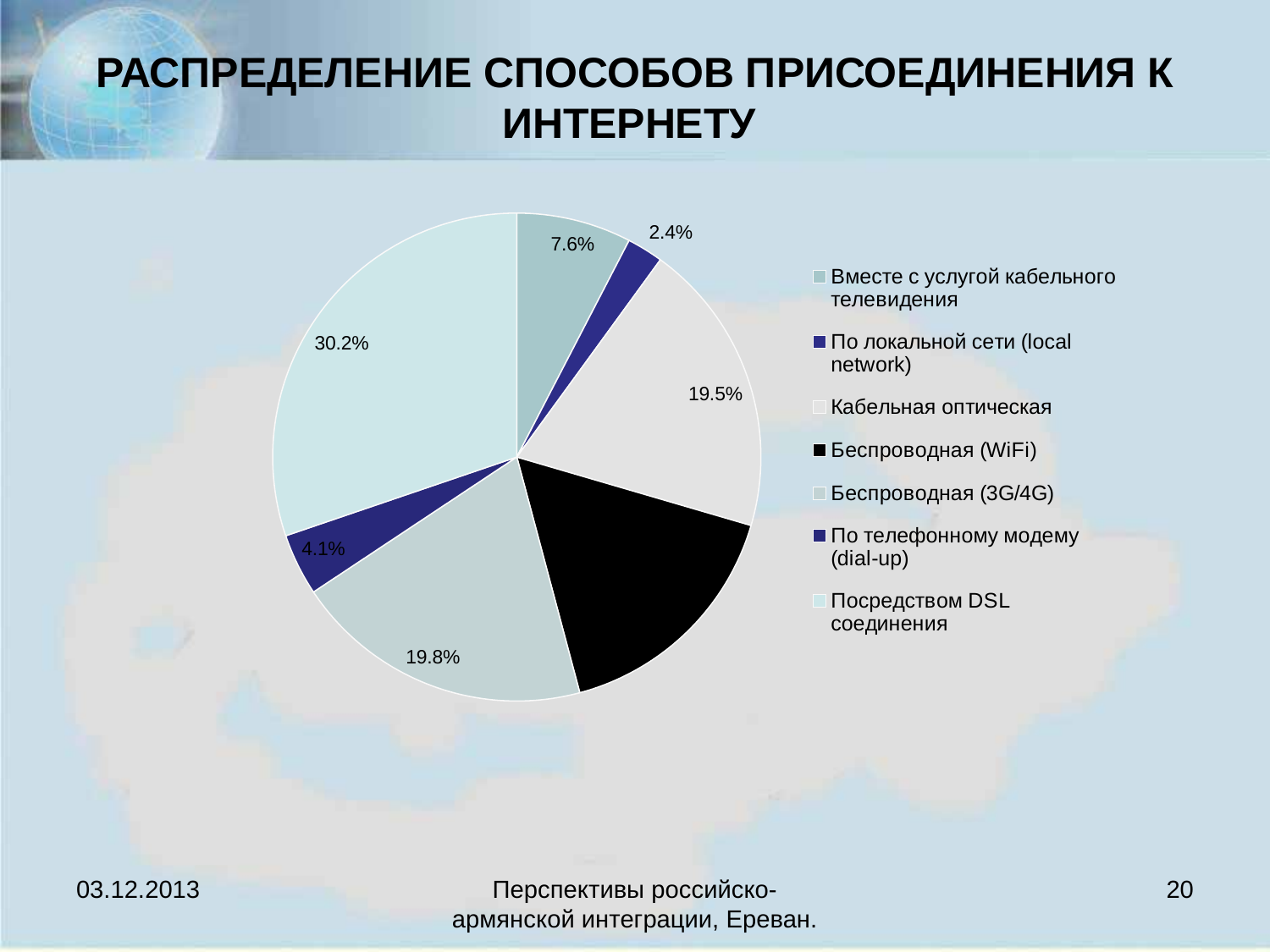
What kind of chart is shown on the slide? pie chart Which connection method has the smallest slice of the pie? По локальной сети (local network) What percentage is shown for "По телефонному модему (dial-up)"? 4.1% How many entries does the legend list? 7 What percentage is shown for "Кабельная оптическая"? 19.5% What percentage is shown for "Беспроводная (3G/4G)"? 19.8% What share of the pie is labelled for "Посредством DSL соединения"? 30.2% What percentage is shown for "По локальной сети (local network)"? 2.4% Which connection method has the largest slice of the pie? Посредством DSL соединения What percentage is shown for "Вместе с услугой кабельного телевидения"? 7.6% What is the difference in percentage points between the DSL slice and the 3G/4G slice? 10.4 What is the title of the slide containing the chart? РАСПРЕДЕЛЕНИЕ СПОСОБОВ ПРИСОЕДИНЕНИЯ К ИНТЕРНЕТУ